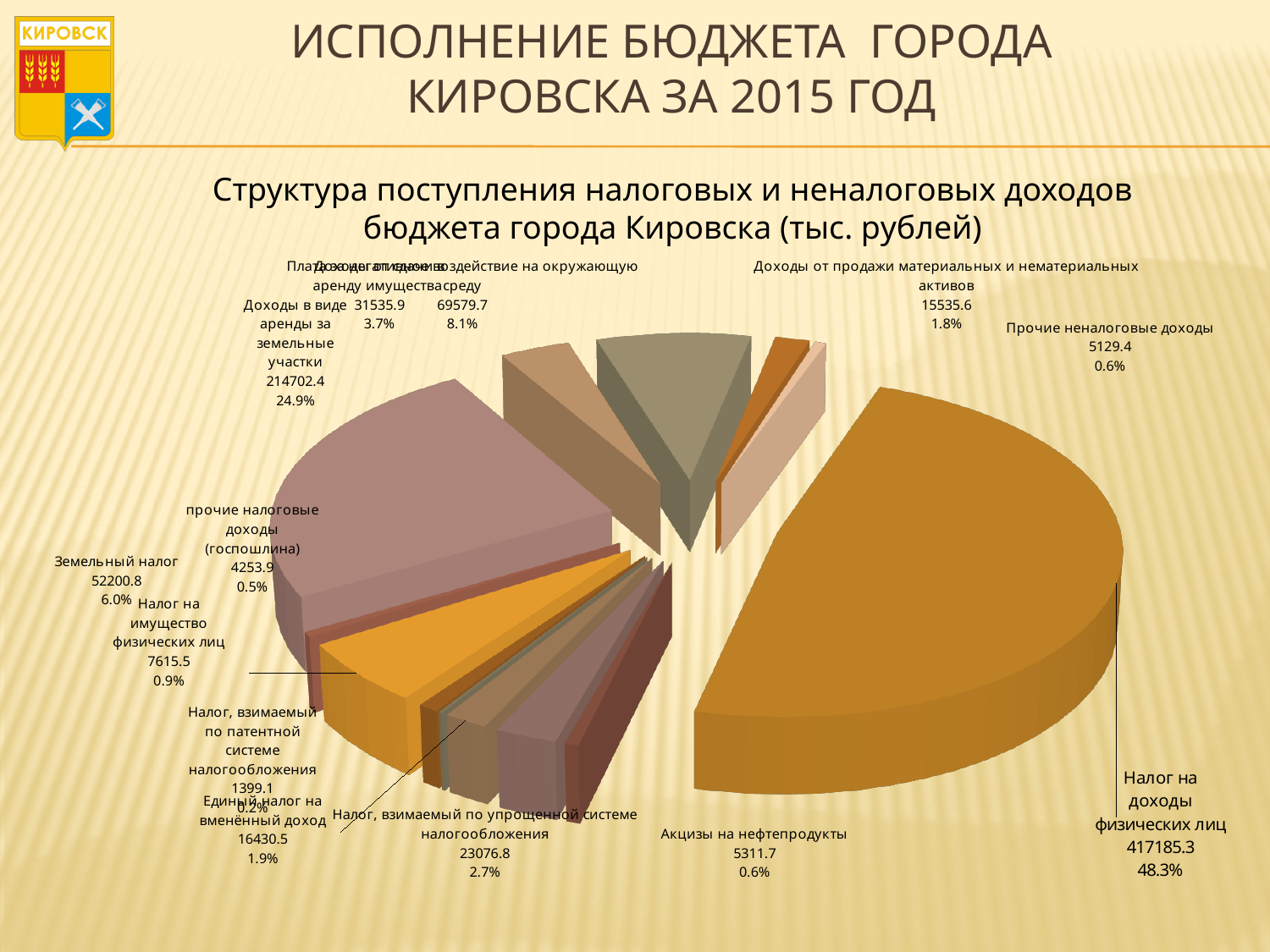
What is the value for Единый налог на вменённый доход? 16430.5 What is the value for Налог на доходы физических лиц? 417185.3 What is the value for Доходы в виде аренды за земельные участки? 214702.4 Which category has the smallest slice of the pie? Налог, взимаемый по патентной системе налогообложения What is the difference between Земельный налог and Налог на имущество физических лиц? 44585.3 In what units are the values in the chart expressed, according to the chart title? тыс. рублей What type of chart is shown on the slide? Pie chart What share of the pie does Земельный налог represent? 6.0% What share of the pie does Налог на доходы физических лиц represent? 48.3% Which category has the largest slice of the pie? Налог на доходы физических лиц Which is larger: Налог, взимаемый по упрощенной системе налогообложения or Единый налог на вменённый доход? Налог, взимаемый по упрощенной системе налогообложения What is the value for Доходы от продажи материальных и нематериальных активов? 15535.6